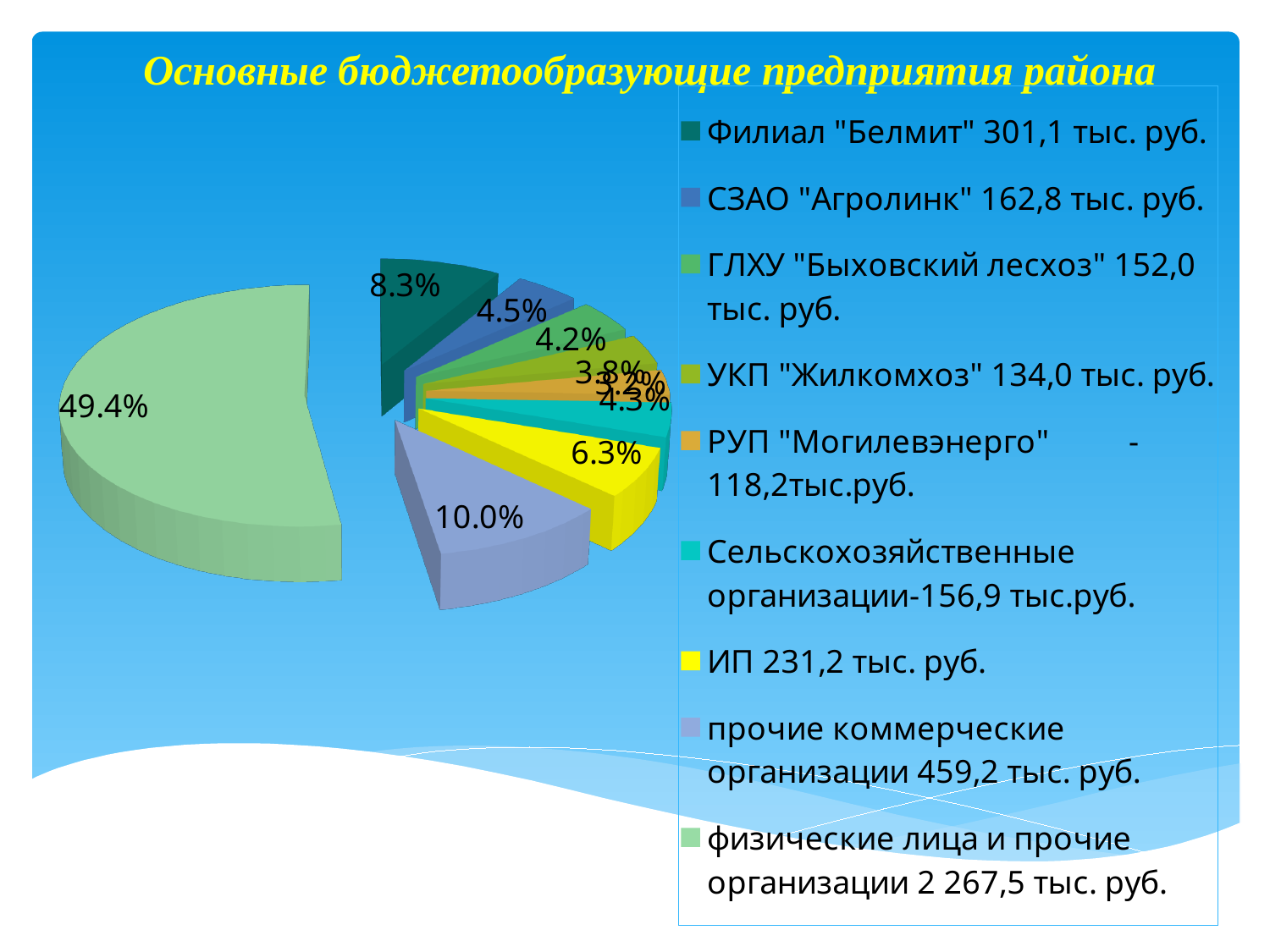
Which category has the largest slice of the pie? физические лица и прочие организации What percentage is shown for ИП? 6.3% What share of the pie does "физические лица и прочие организации" account for? 49.4% Which is larger: the slice for ИП or the slice for Филиал "Белмит"? Филиал "Белмит" What percentage is shown for ГЛХУ "Быховский лесхоз"? 4.2% What type of chart is shown on the slide? Pie chart How many categories does the legend list? 9 What percentage is shown for "прочие коммерческие организации"? 10.0% What is the title of the slide? Основные бюджетообразующие предприятия района What percentage is shown for Филиал "Белмит"? 8.3% What is the difference in percentage points between the slice for "физические лица и прочие организации" and the slice for "прочие коммерческие организации"? 39.4% What percentage is shown for СЗАО "Агролинк"? 4.5%